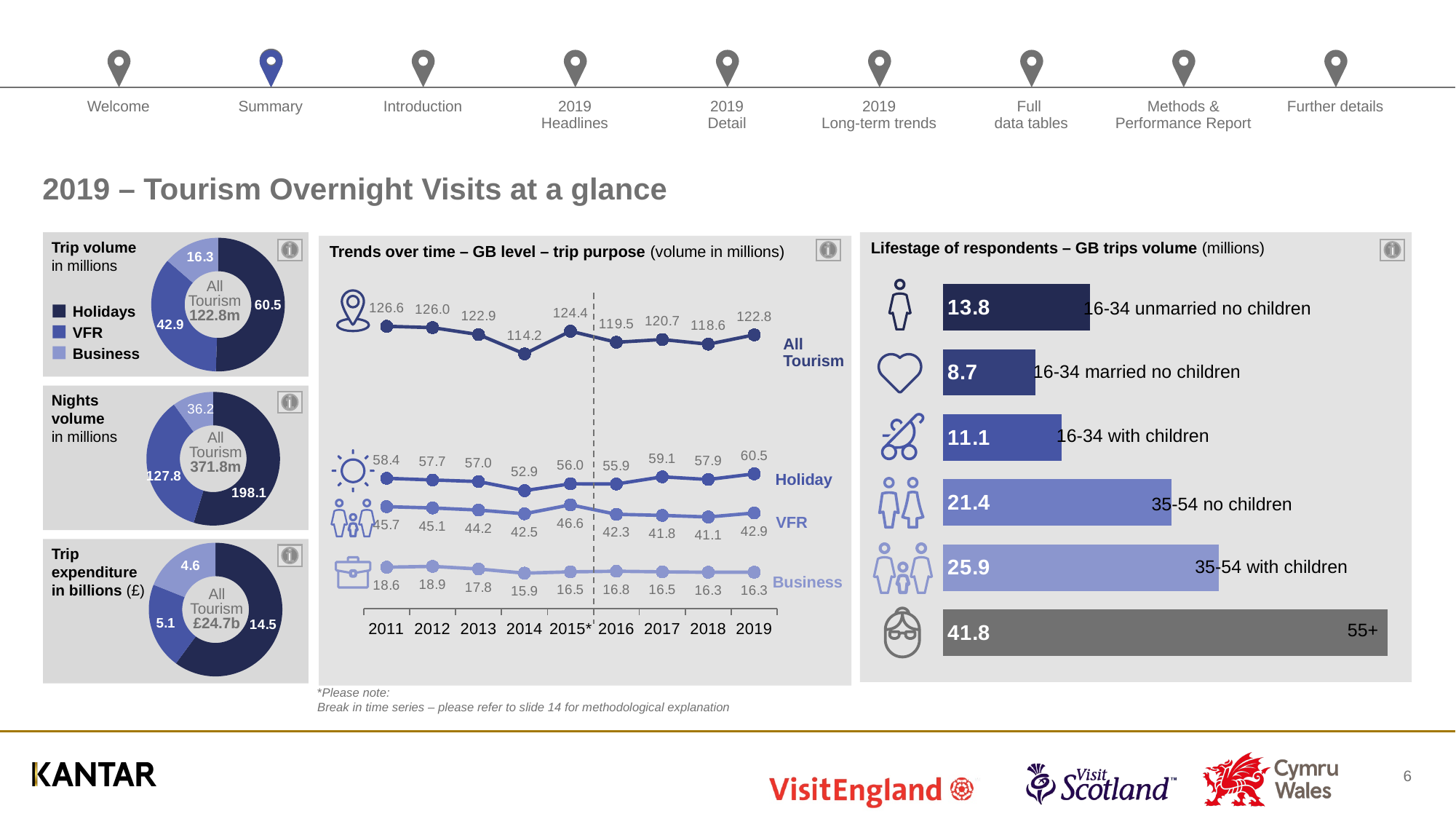
In the 'Trends over time – GB level – trip purpose' line chart, how many years are shown on the x axis? 9 In the 'Trends over time – GB level – trip purpose' line chart, what is the difference between the VFR values for 2015* and 2019? 3.7 In the 'Lifestage of respondents – GB trips volume' chart, which is larger: 16-34 married no children or 16-34 with children? 16-34 with children In the 'Trip volume in millions' donut chart, what is the value for Holidays? 60.5 In the 'Lifestage of respondents – GB trips volume' chart, what is the value for 35-54 with children? 25.9 In the 'Nights volume in millions' donut chart, what is the value for VFR? 127.8 In the 'Trends over time – GB level – trip purpose' line chart, how many series are plotted? 4 In the 'Trip expenditure in billions (£)' donut chart, which segment is the smallest? Business In the 'Trends over time – GB level – trip purpose' line chart, which year has the highest Holiday value? 2019 What kind of chart is the 'Lifestage of respondents – GB trips volume' chart? Bar chart In the 'Trends over time – GB level – trip purpose' line chart, what is the All Tourism value for 2014? 114.2 In the 'Lifestage of respondents – GB trips volume' chart, which lifestage group has the highest value? 55+